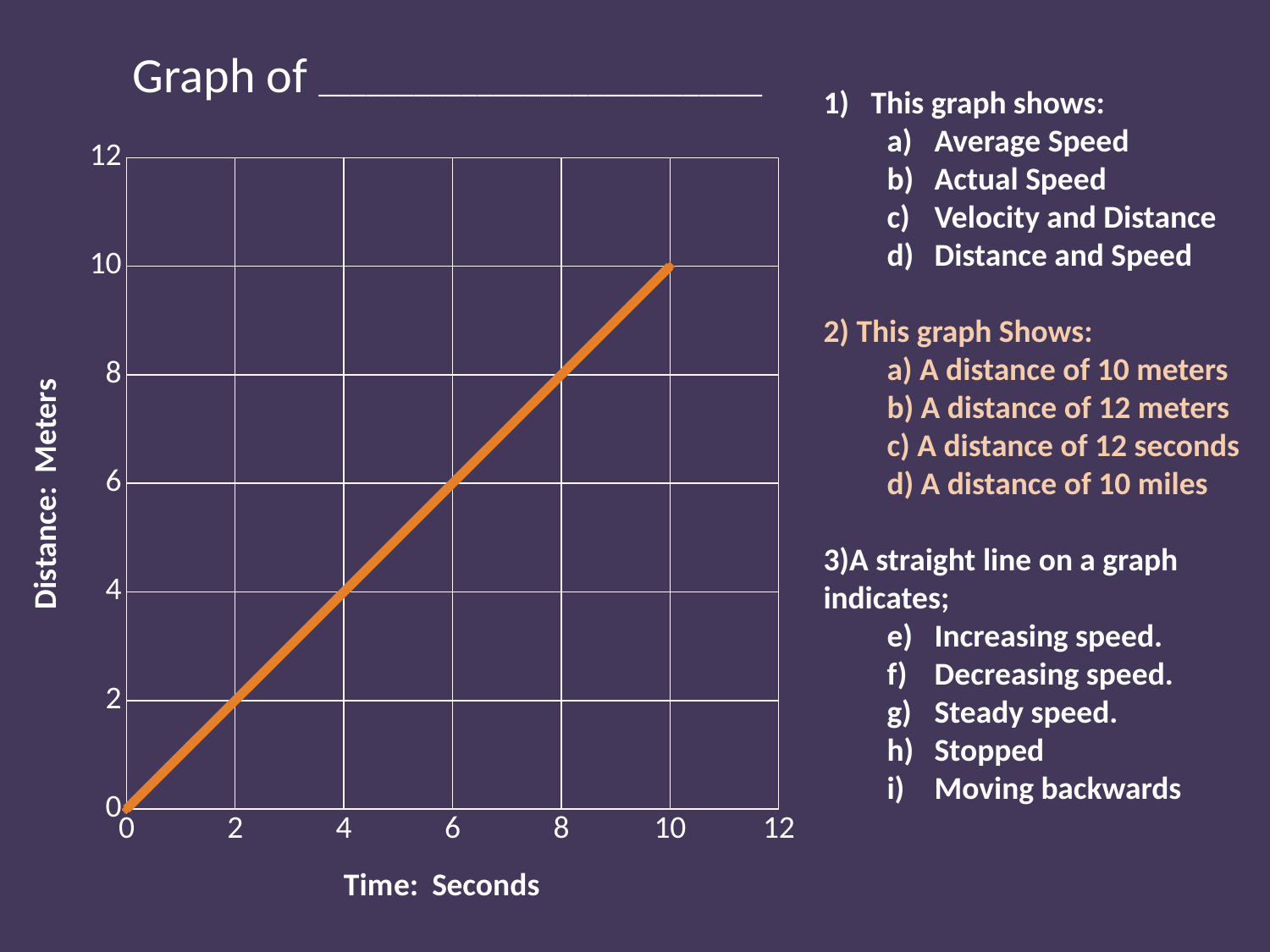
What is the distance at time 0 seconds? 0 What is the label of the x axis? Time: Seconds What is the highest value shown on the y axis? 12 What distance does the line show at a time of 6 seconds? 6 What kind of chart is shown on the slide? line chart What is the label of the y axis? Distance: Meters Which is larger, the distance at 4 seconds or the distance at 8 seconds? 8 seconds What distance does the line show at a time of 4 seconds? 4 Does the distance rise or fall as time increases along the x axis? rise What distance does the line reach at a time of 10 seconds? 10 What is the difference in distance between time 10 seconds and time 2 seconds? 8 Is the distance at 8 seconds greater or less than 6? greater